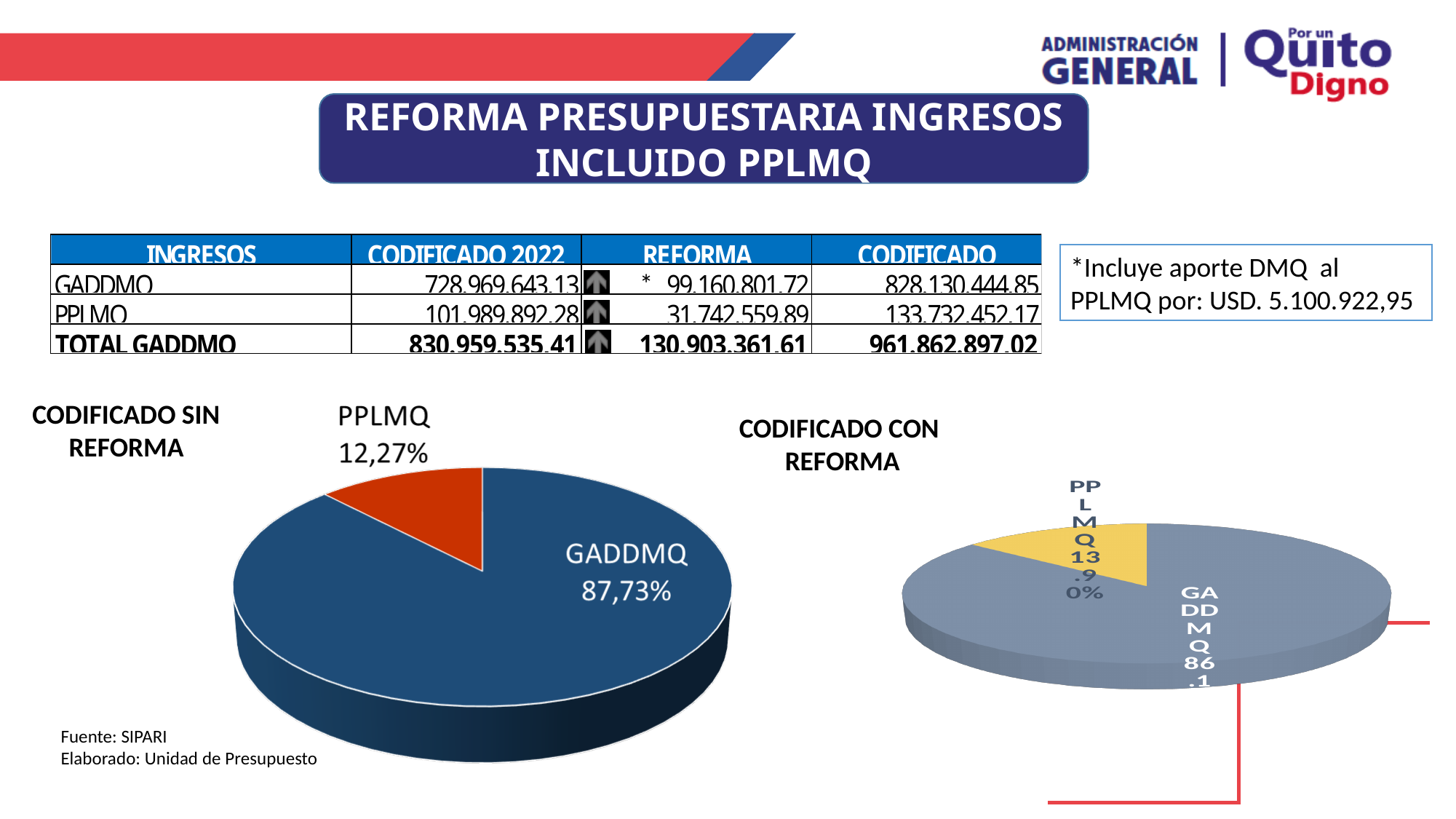
In the "CODIFICADO SIN REFORMA" chart, what share does GADDMQ have? 87,73% In the "CODIFICADO CON REFORMA" chart, what colour is the PPLMQ slice? yellow In the "CODIFICADO SIN REFORMA" chart, what share does PPLMQ have? 12,27% In the "CODIFICADO CON REFORMA" chart, what share does PPLMQ have? 13.90% What kind of chart is the "CODIFICADO CON REFORMA" chart? pie chart In the "CODIFICADO SIN REFORMA" chart, which slice is the smallest? PPLMQ In the "CODIFICADO SIN REFORMA" chart, how many slices are there? 2 In the "CODIFICADO CON REFORMA" chart, which slice is the largest? GADDMQ In the "CODIFICADO SIN REFORMA" chart, what is the difference between the GADDMQ and PPLMQ shares? 75,46% In the "CODIFICADO SIN REFORMA" chart, what colour is the PPLMQ slice? red What kind of chart is the "CODIFICADO SIN REFORMA" chart? pie chart In the "CODIFICADO SIN REFORMA" chart, which slice is the largest? GADDMQ